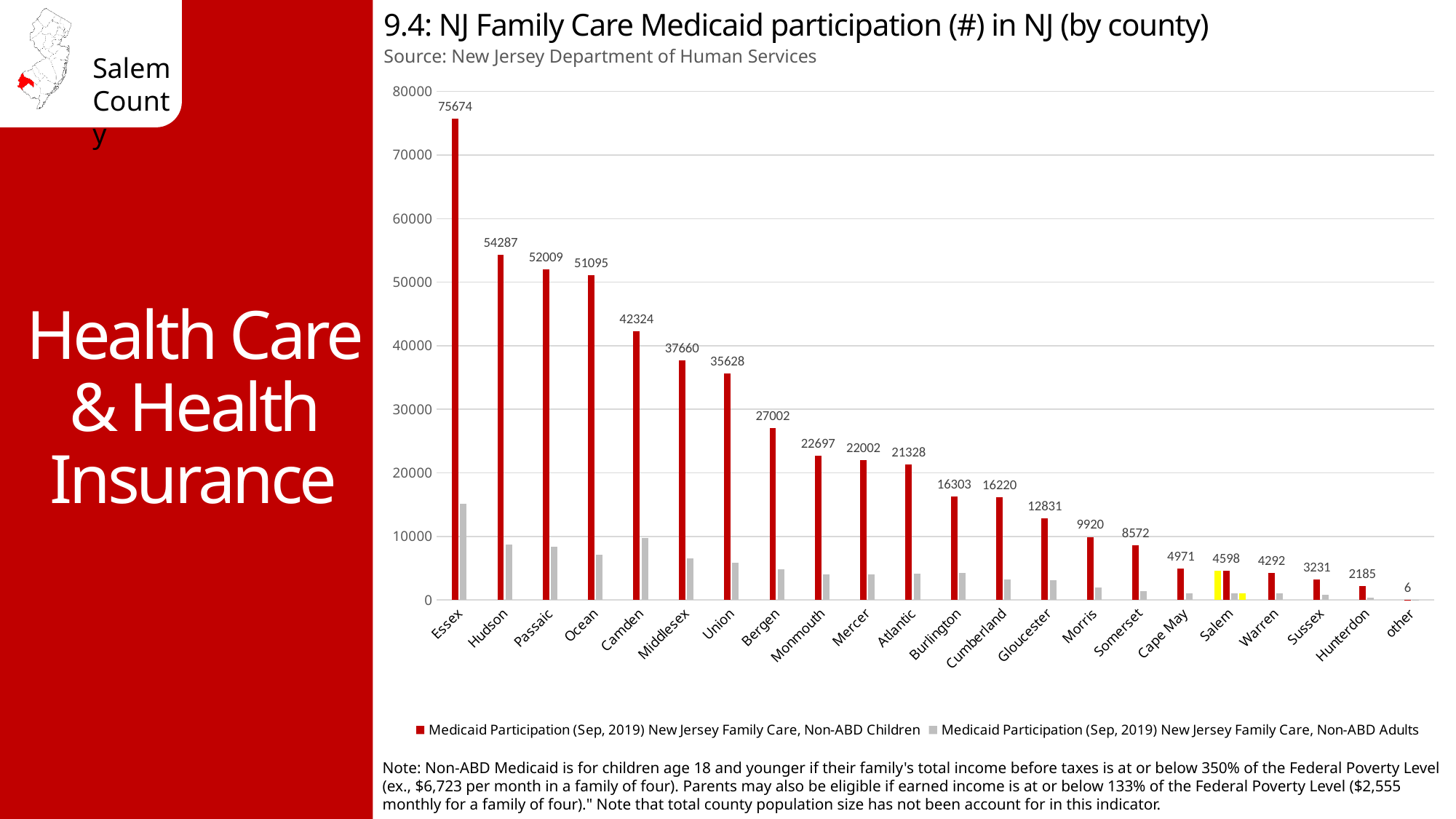
How many categories are shown on the x axis? 22 What is the difference between the Non-ABD Children values for Hudson and Passaic? 2278 Which category has the lowest Non-ABD Children Medicaid participation? other What is the Non-ABD Children Medicaid participation value for Essex? 75674 Which has a larger Non-ABD Children value, Camden or Middlesex? Camden Which county has the highest Non-ABD Children Medicaid participation? Essex Do the Non-ABD Children values rise or fall from left to right along the x axis? fall What kind of chart is shown on the slide? bar chart Is the Non-ABD Adults value for Essex greater or less than 10000? greater What is the difference between the Non-ABD Children values for Essex and Hudson? 21387 What is the Non-ABD Children Medicaid participation value for Salem? 4598 How many series does the legend list? 2